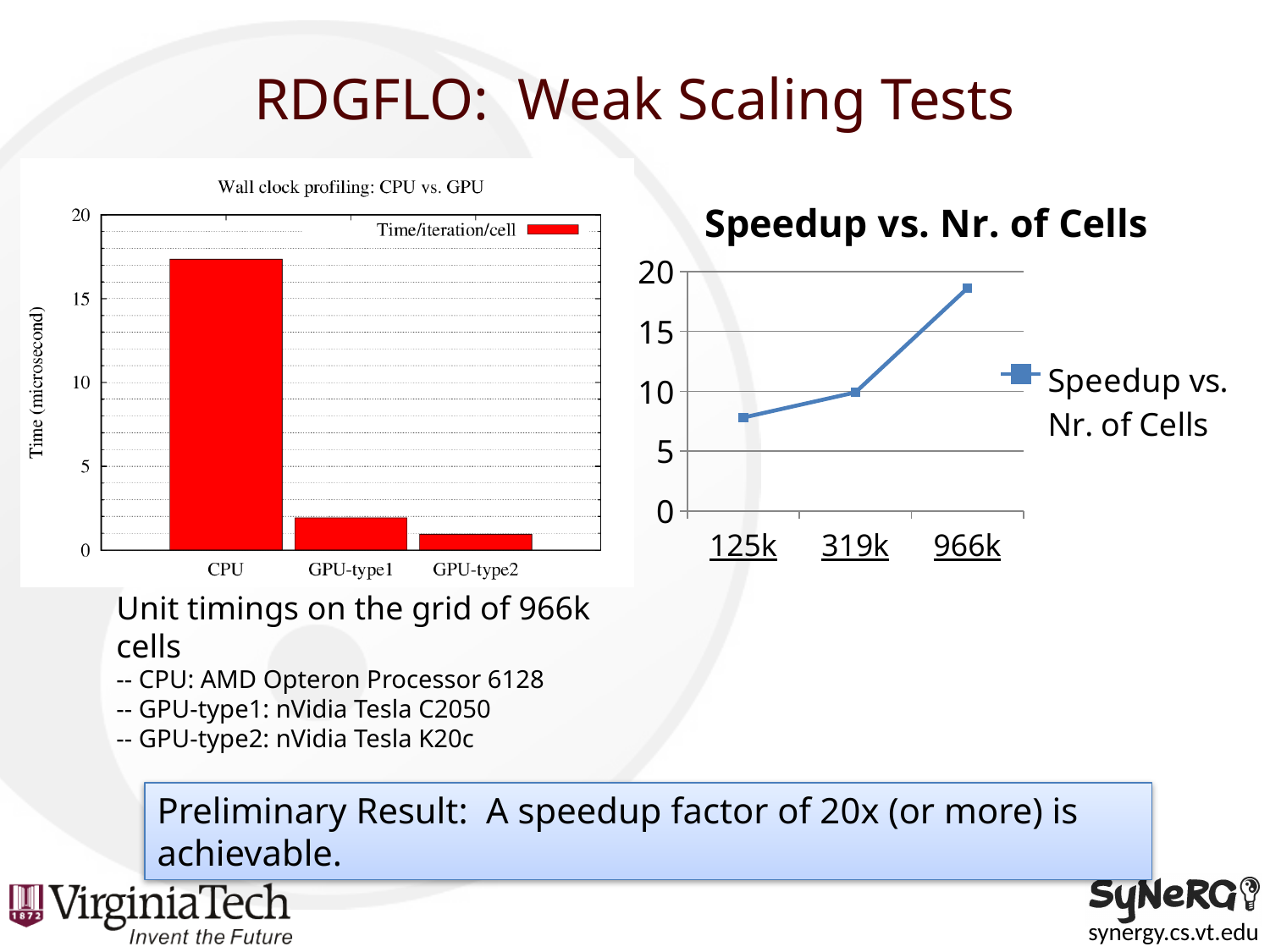
What kind of chart is the 'Speedup vs. Nr. of Cells' chart? line chart In the 'Wall clock profiling: CPU vs. GPU' chart, which is larger, the value for GPU-type1 or GPU-type2? GPU-type1 In the 'Speedup vs. Nr. of Cells' chart, how many data points are plotted? 3 In the 'Speedup vs. Nr. of Cells' chart, do the values rise or fall as the number of cells increases? rise What kind of chart is the 'Wall clock profiling: CPU vs. GPU' chart? bar chart In the 'Wall clock profiling: CPU vs. GPU' chart, is the value for GPU-type1 greater or less than 5? less What is the y-axis label of the 'Wall clock profiling: CPU vs. GPU' chart? Time (microsecond) In the 'Wall clock profiling: CPU vs. GPU' chart, which category has the lowest time? GPU-type2 In the 'Speedup vs. Nr. of Cells' chart, is the value for 966k greater or less than 15? greater In the 'Wall clock profiling: CPU vs. GPU' chart, how many categories are shown on the x axis? 3 In the 'Wall clock profiling: CPU vs. GPU' chart, is the value for CPU greater or less than 15? greater In the 'Wall clock profiling: CPU vs. GPU' chart, which category has the highest time? CPU